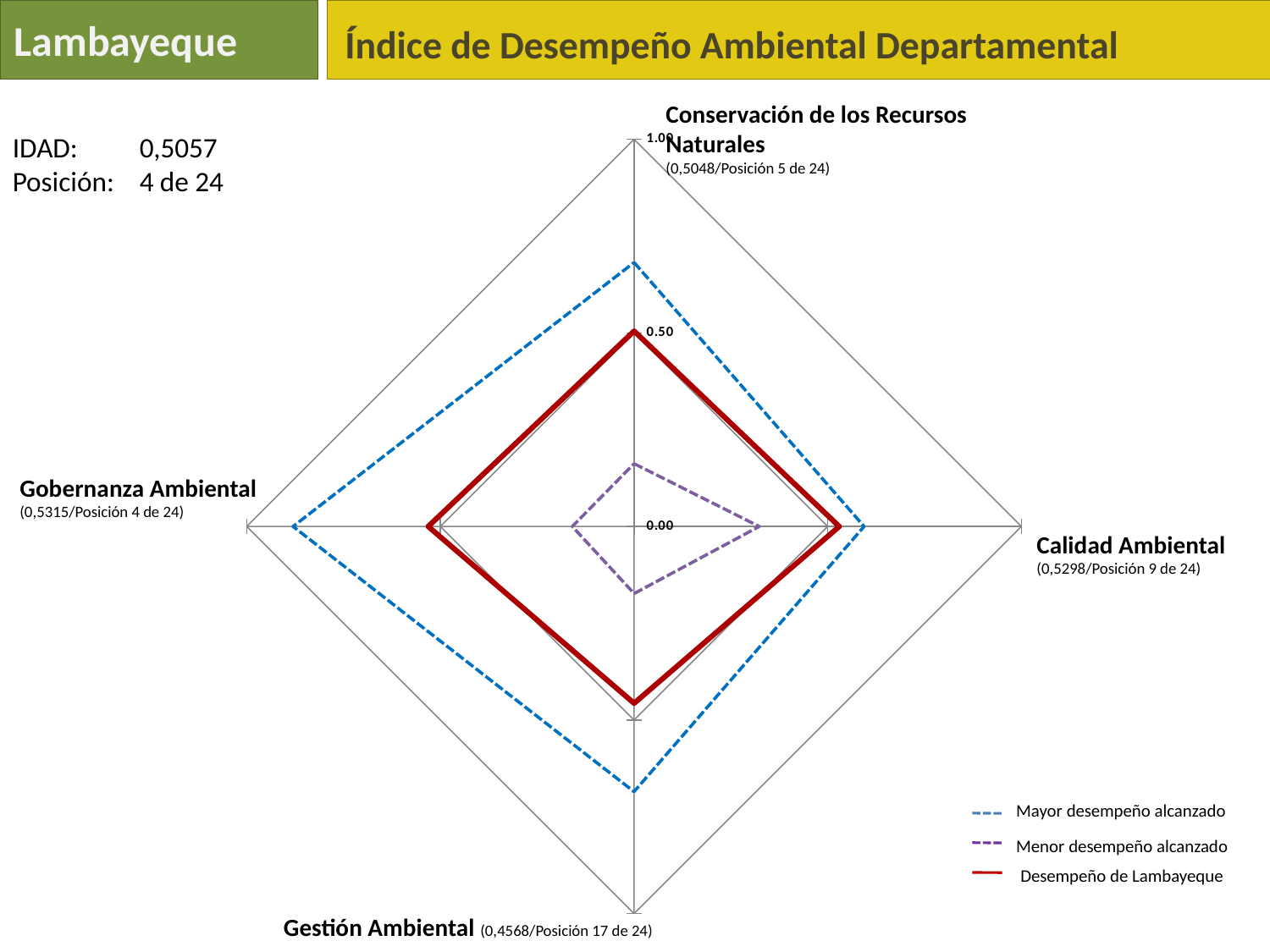
How many axes (categories) does the radar chart have? 4 What position does Lambayeque hold for Conservación de los Recursos Naturales? 5 de 24 Is the 'Mayor desempeño alcanzado' value for Gestión Ambiental greater or less than 0.50? greater In which category does Lambayeque have its lowest value? Gestión Ambiental Is the 'Menor desempeño alcanzado' value for Conservación de los Recursos Naturales greater or less than 0.50? less How many series does the legend list? 3 Which series is drawn with the solid red line? Desempeño de Lambayeque What is Lambayeque's value for Gobernanza Ambiental? 0,5315 What kind of chart is shown on the slide? Radar chart What is Lambayeque's value for Gestión Ambiental? 0,4568 What is the difference between Lambayeque's values for Gobernanza Ambiental and Gestión Ambiental? 0,0747 What is Lambayeque's value for Calidad Ambiental? 0,5298